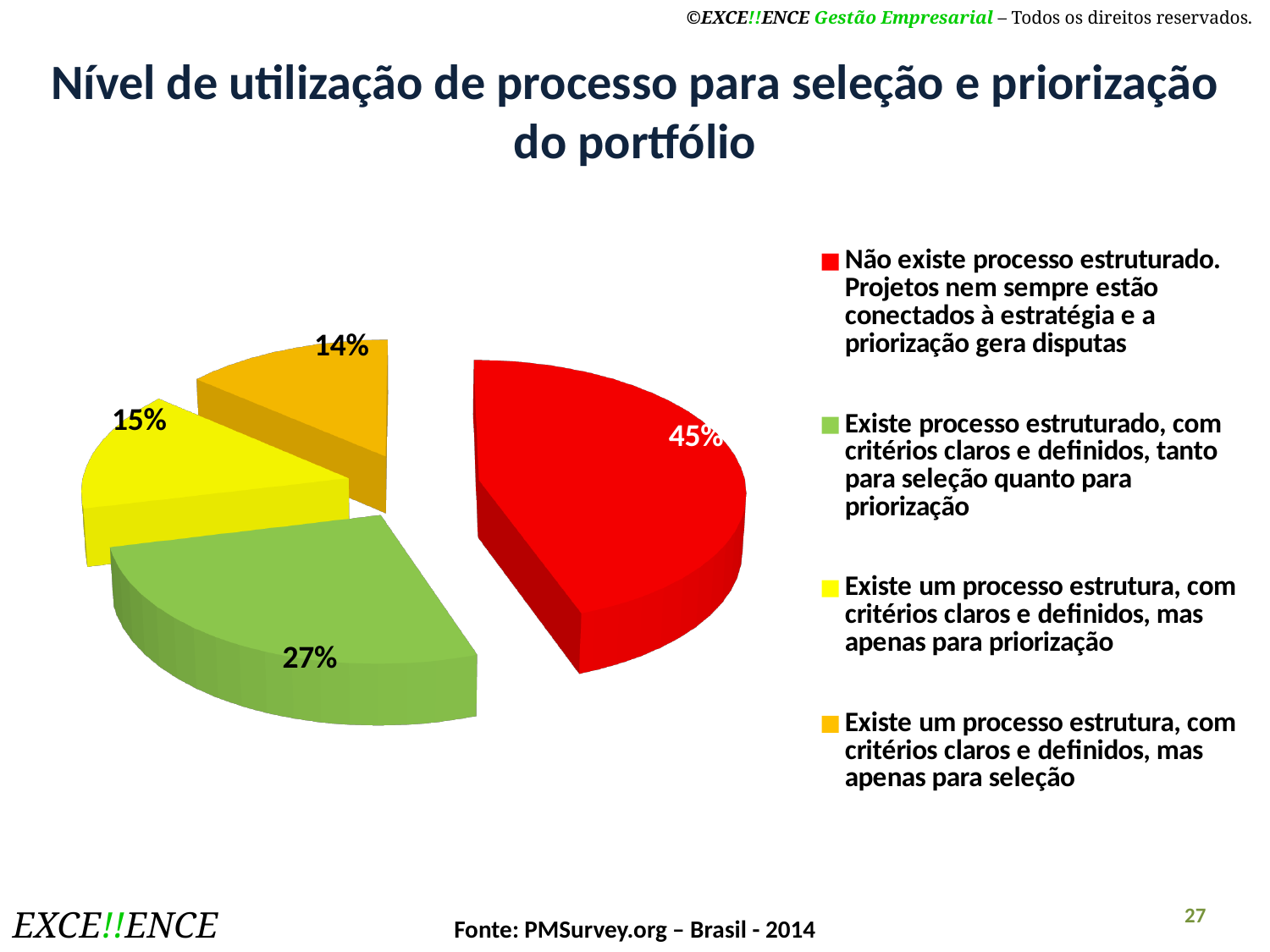
Which category has the largest share of the pie? Não existe processo estruturado. Projetos nem sempre estão conectados à estratégia e a priorização gera disputas What kind of chart is shown on the slide? pie chart What percentage of the pie corresponds to "Não existe processo estruturado. Projetos nem sempre estão conectados à estratégia e a priorização gera disputas"? 45% What percentage is shown for the category "Existe um processo estrutura, com critérios claros e definidos, mas apenas para priorização"? 15% Which category has the smallest share of the pie? Existe um processo estrutura, com critérios claros e definidos, mas apenas para seleção Which is larger: the share for "Não existe processo estruturado" or the share for "Existe processo estruturado ... tanto para seleção quanto para priorização"? Não existe processo estruturado What colour is the slice representing 45%? red What is the difference in percentage points between the largest slice (45%) and the green slice (27%)? 18 What is the title of the chart on the slide? Nível de utilização de processo para seleção e priorização do portfólio What percentage is shown for "Existe processo estruturado, com critérios claros e definidos, tanto para seleção quanto para priorização"? 27% What percentage is shown for the category "Existe um processo estrutura, com critérios claros e definidos, mas apenas para seleção"? 14% How many slices does the pie chart have? 4